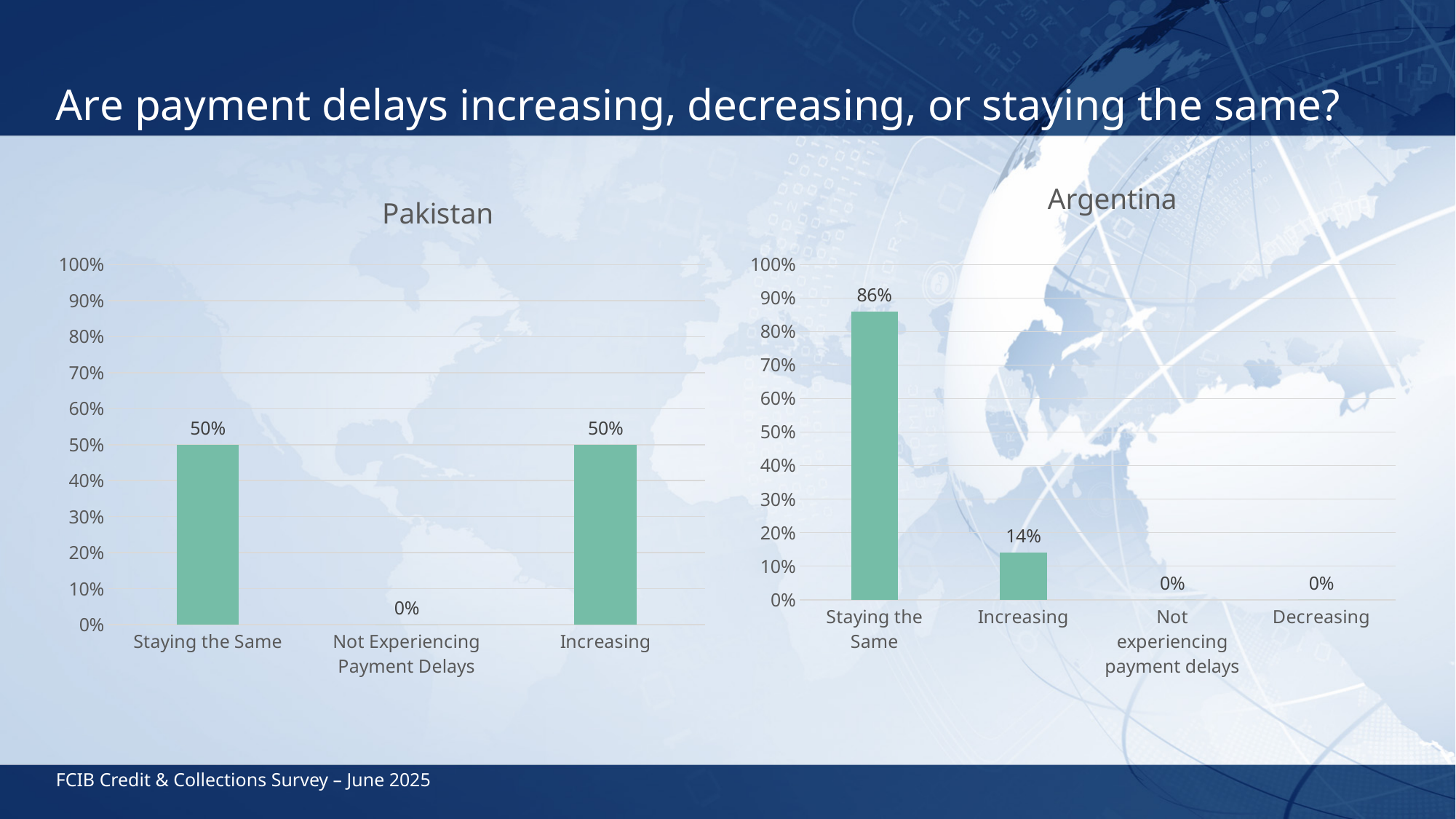
What is the title of the chart on the right side of the slide? Argentina In the Argentina chart, which category has the highest value? Staying the Same What kind of chart is the Pakistan chart? Bar chart In the Pakistan chart, which category has the lowest value? Not Experiencing Payment Delays In the Argentina chart, what is the difference between Staying the Same and Increasing? 72% How many categories are shown in the Pakistan chart? 3 In the Argentina chart, what is the value for Staying the Same? 86% In the Pakistan chart, what is the value for Not Experiencing Payment Delays? 0% In the Argentina chart, which is larger, Staying the Same or Increasing? Staying the Same In the Argentina chart, what is the value for Increasing? 14% In the Pakistan chart, what is the value for Staying the Same? 50% How many categories are shown in the Argentina chart? 4